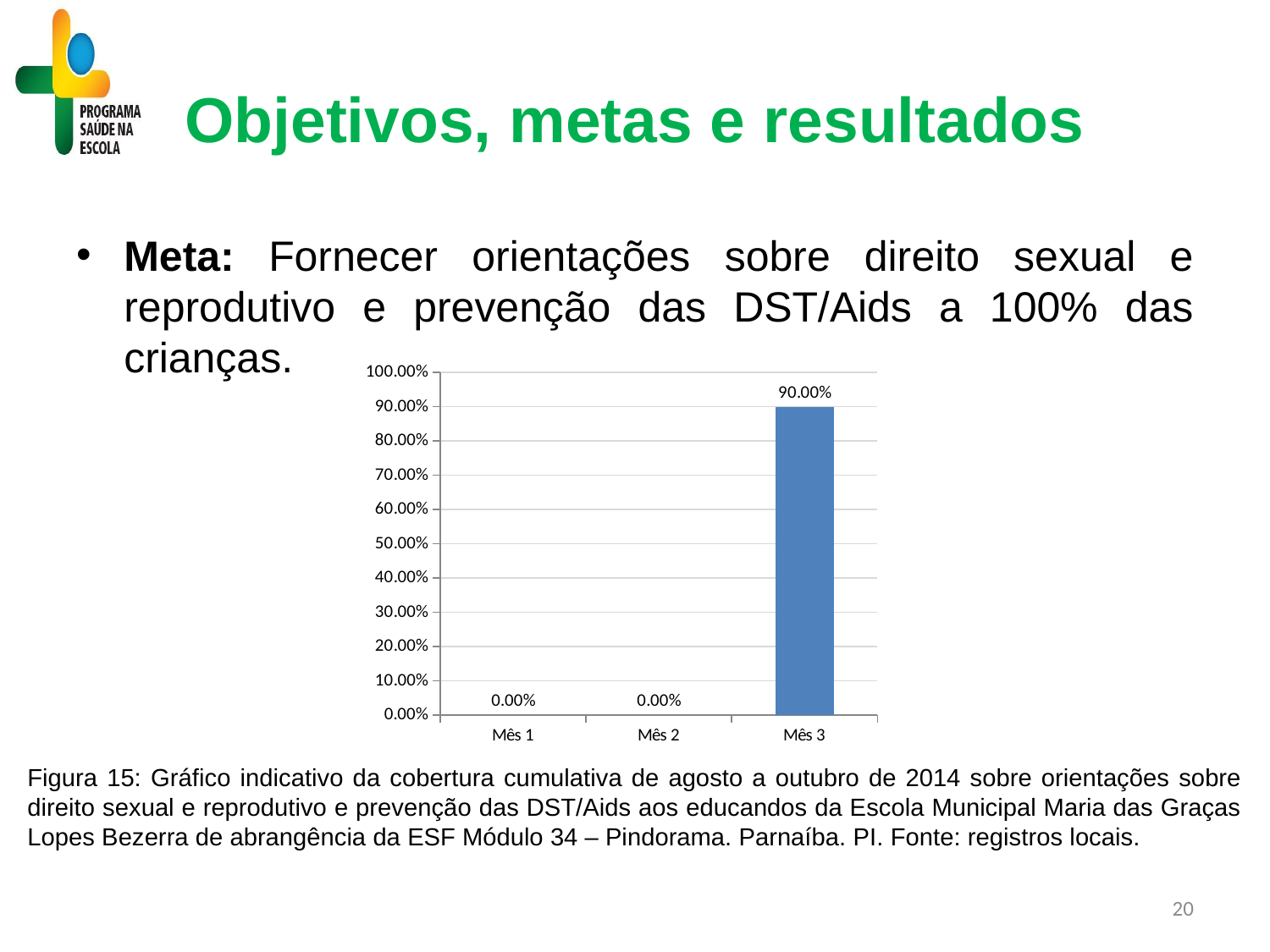
Do the values rise or fall from Mês 1 to Mês 3? rise What is the value for Mês 2? 0.00% What is the difference between the values for Mês 3 and Mês 2? 90.00% How many categories are shown on the x axis? 3 Which month has the highest value? Mês 3 What is the highest value shown on the y axis? 100.00% What kind of chart is shown on the slide? bar chart Is the value for Mês 3 greater or less than 80.00%? greater Which is larger, the value for Mês 3 or the value for Mês 1? Mês 3 What colour is the bar for Mês 3? blue What is the value for Mês 1? 0.00% What is the value for Mês 3? 90.00%